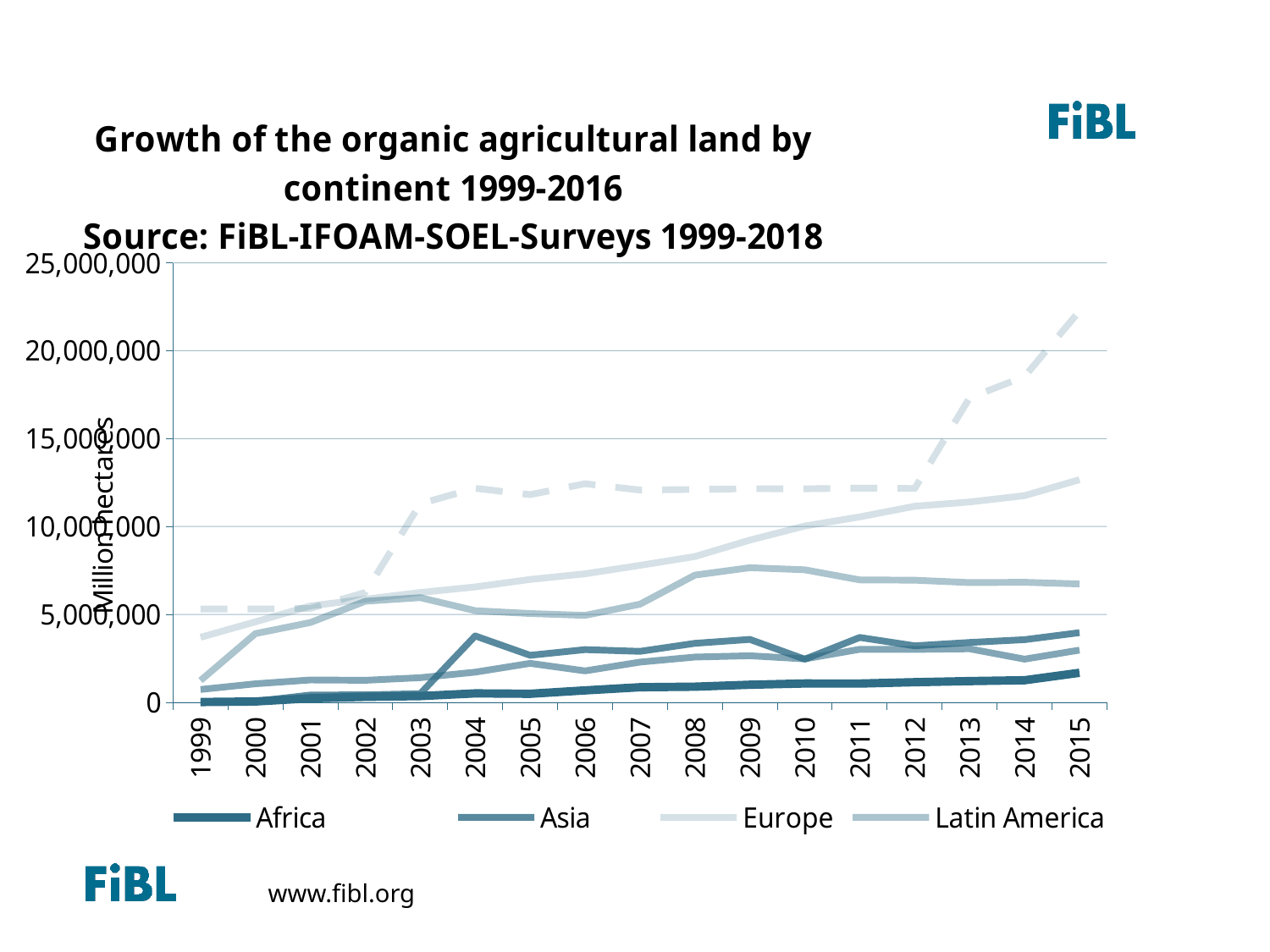
Does the value for Europe rise or fall from 1999 to 2015? rise In 2015, which is larger: the value for Europe or the value for Africa? Europe How many years are shown along the x axis? 17 Is the value for Latin America in 2009 greater or less than 5,000,000? greater What kind of chart is shown on the slide? line chart How many series does the legend list? 4 Among Africa, Asia, Europe and Latin America, which has the highest value in 2015? Europe Is the value for Asia in 2015 greater or less than 5,000,000? less Is the value for Africa in 2015 greater or less than 5,000,000? less Does the value for Africa rise or fall from 1999 to 2015? rise What is the label on the y axis? Million hectares